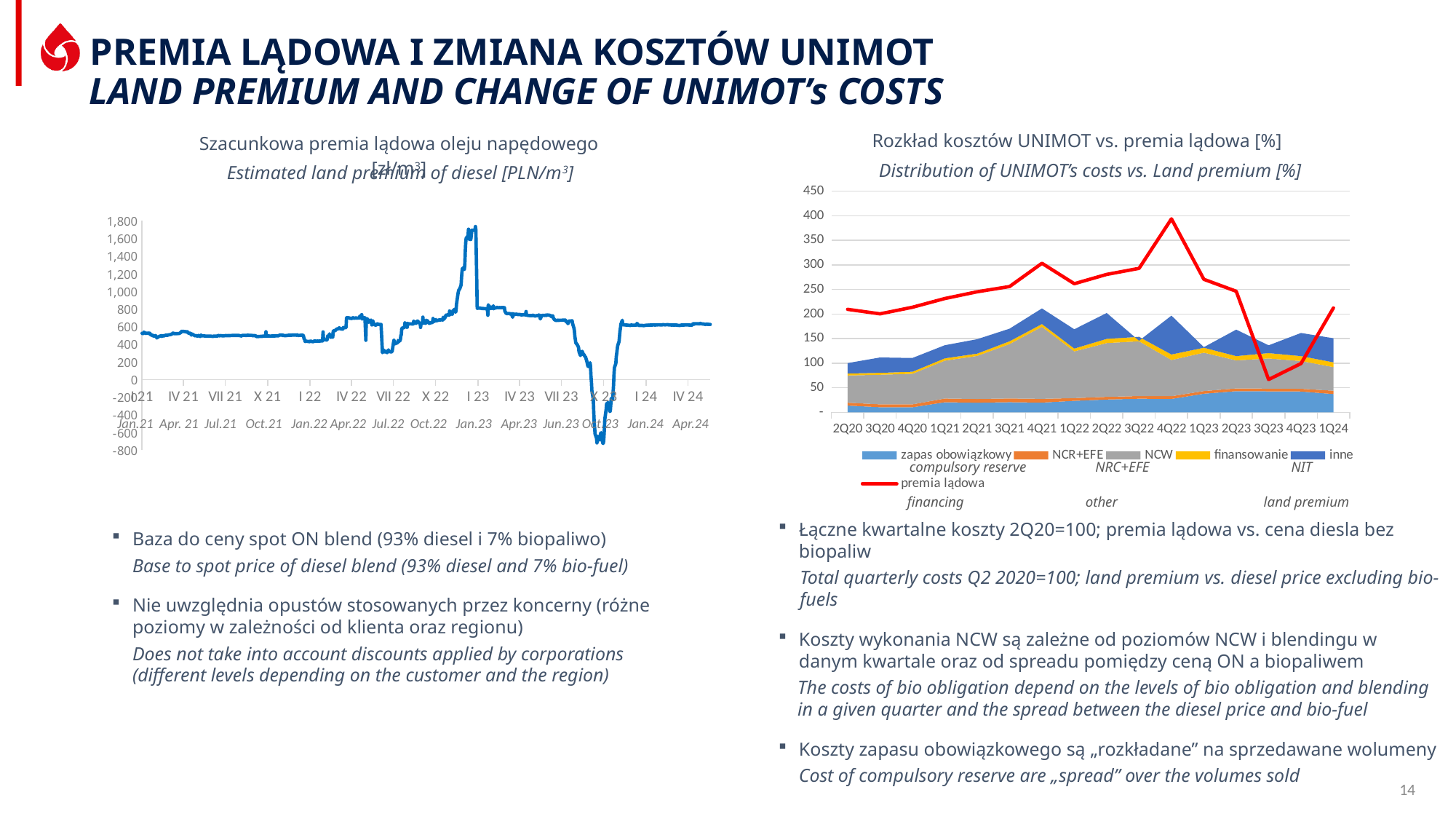
In the right chart, 'Distribution of UNIMOT's costs vs. Land premium [%]', does the 'premia lądowa' line rise or fall between 4Q22 and 3Q23? fall In the right chart, 'Distribution of UNIMOT's costs vs. Land premium [%]', what colour is the 'premia lądowa' line? red In the right chart, 'Distribution of UNIMOT's costs vs. Land premium [%]', how many quarters are shown on the x axis? 16 In the right chart, 'Distribution of UNIMOT's costs vs. Land premium [%]', how many series does the legend list? 6 In the right chart, 'Distribution of UNIMOT's costs vs. Land premium [%]', is the 'premia lądowa' value for 3Q23 greater or less than 100? less In the right chart, 'Distribution of UNIMOT's costs vs. Land premium [%]', is the 'premia lądowa' value for 4Q22 greater or less than 350? greater What kind of chart is the left chart, 'Estimated land premium of diesel [PLN/m3]'? line chart In the right chart, 'Distribution of UNIMOT's costs vs. Land premium [%]', in which quarter does the 'premia lądowa' line reach its highest value? 4Q22 In the left chart, 'Estimated land premium of diesel [PLN/m3]', is the peak value reached around Jan.23 greater or less than 1,600? greater In the right chart, 'Distribution of UNIMOT's costs vs. Land premium [%]', in which quarter does the 'premia lądowa' line reach its lowest value? 3Q23 In the right chart, 'Distribution of UNIMOT's costs vs. Land premium [%]', is the 'premia lądowa' value for 4Q22 larger or smaller than the value for 1Q23? larger